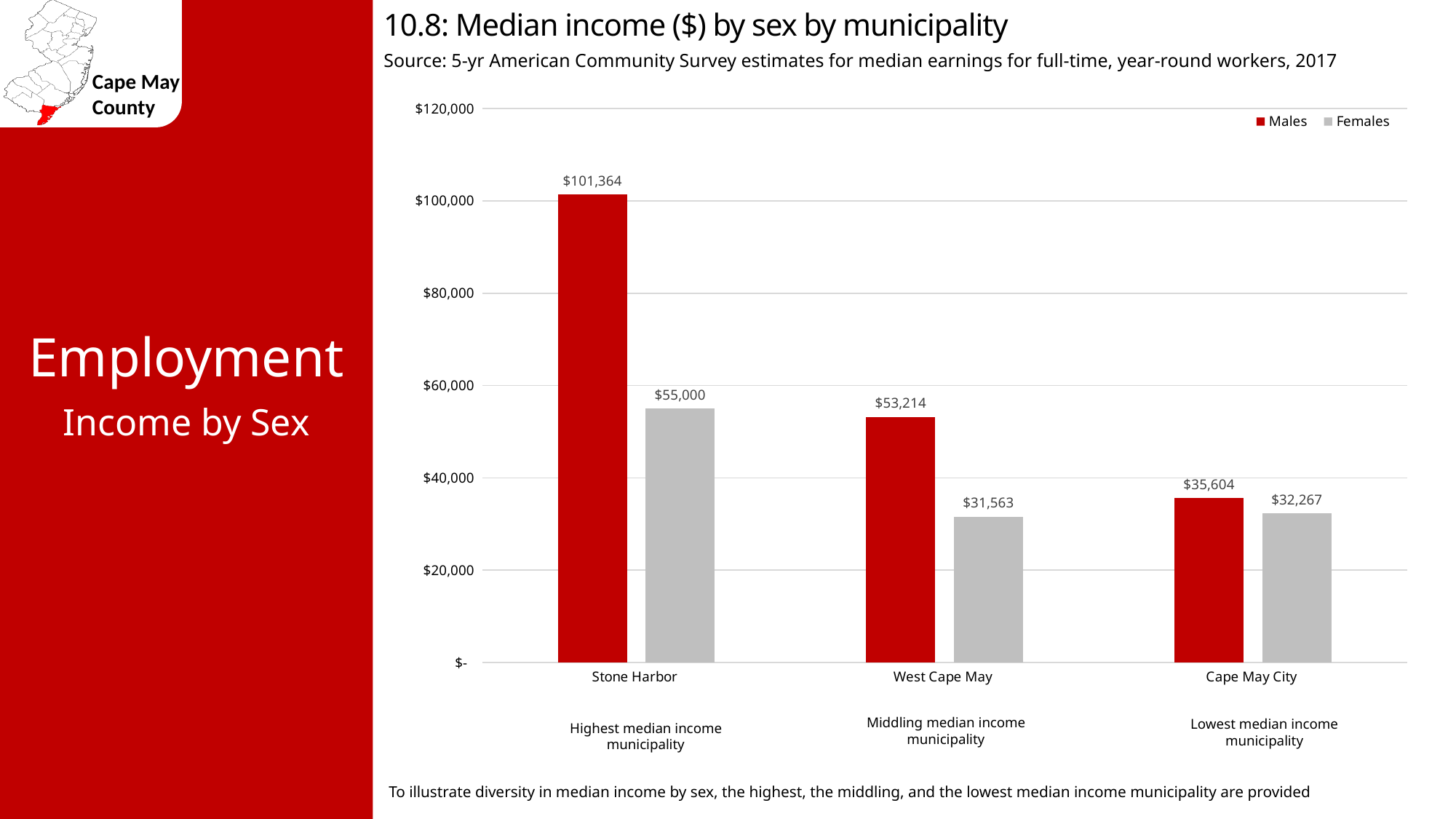
What is the difference between male and female median income in Cape May City? $3,337 Which municipality has the highest median income for males? Stone Harbor What is the difference between male and female median income in Stone Harbor? $46,364 What is the median income for females in Cape May City? $32,267 What is the median income for males in Stone Harbor? $101,364 Which municipality has the lowest median income for females? West Cape May What is the median income for females in West Cape May? $31,563 Is the male median income in West Cape May greater or less than $60,000? less What kind of chart is shown on the slide? Bar chart Which is larger, the female median income in Stone Harbor or the male median income in West Cape May? Female median income in Stone Harbor How many municipalities are shown on the chart? 3 How many series does the legend list? 2